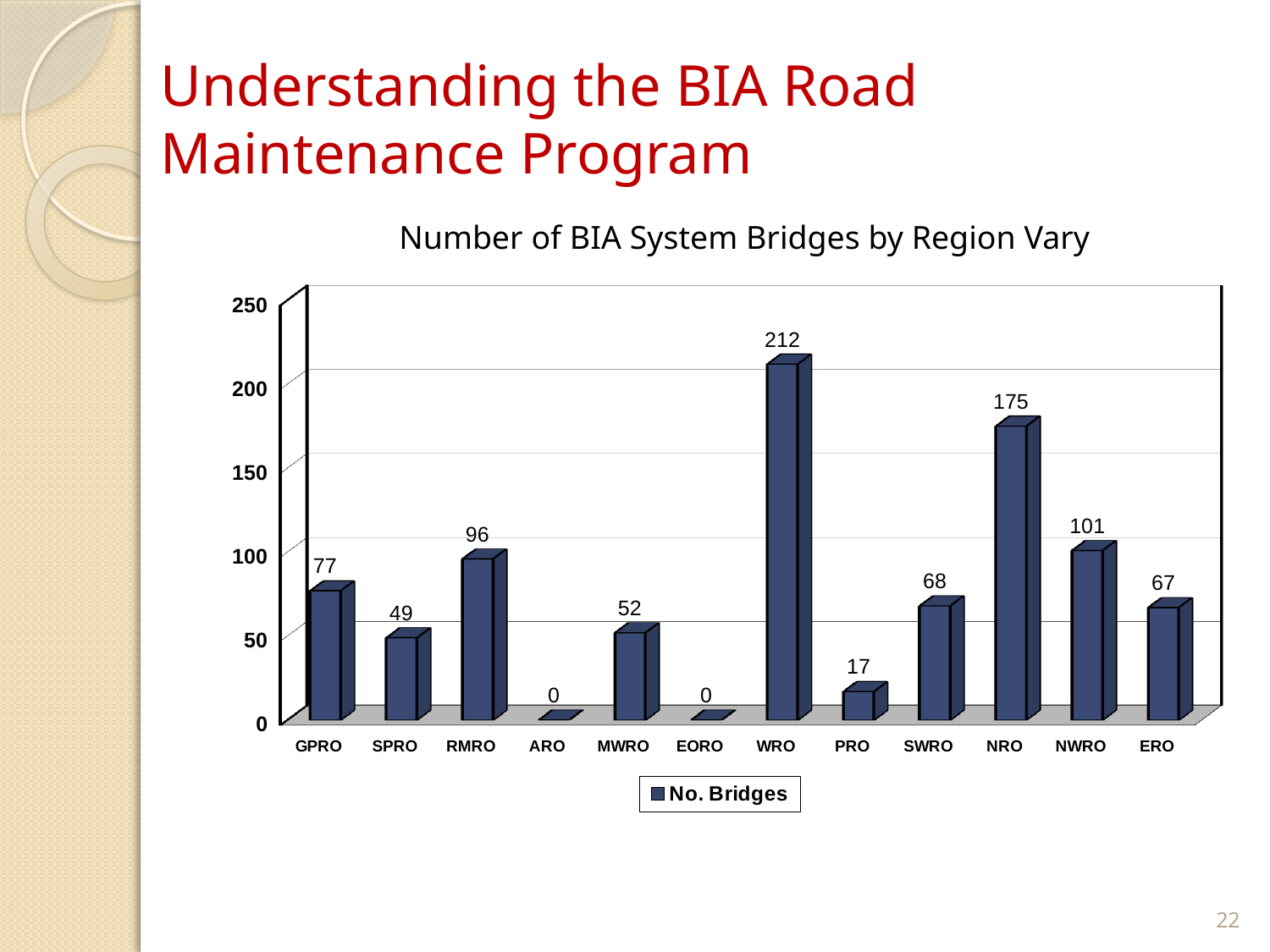
What is the difference in number of bridges between WRO and NRO? 37 Is the value for SWRO greater or less than 100? less What is the number of bridges for WRO? 212 Which regions have a value of 0 bridges? ARO and EORO Which has more bridges, GPRO or RMRO? RMRO What is the number of bridges for SPRO? 49 Which region has the highest number of bridges? WRO What kind of chart is shown on the slide? bar chart How many regions are shown on the x axis? 12 What is the number of bridges for NWRO? 101 What is the title of the chart? Number of BIA System Bridges by Region Vary How many series does the legend list? 1